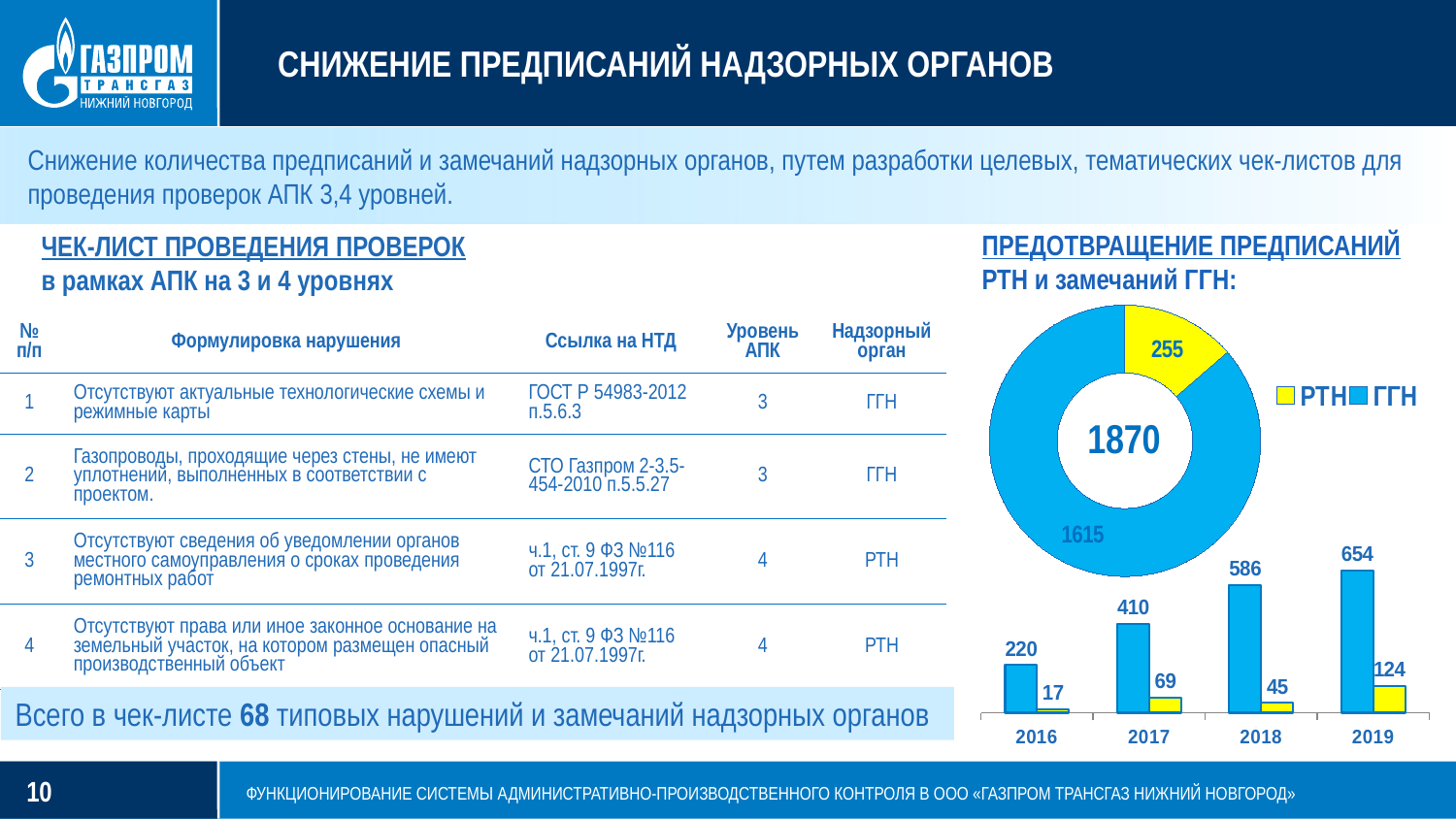
What number is shown in the centre of the doughnut chart? 1870 In the bar chart, which year has the highest blue (ГГН) bar? 2019 In the bar chart, which year has the lowest yellow (РТН) bar? 2016 In the doughnut chart, which category has the larger value, РТН or ГГН? ГГН In the doughnut chart, what is the value for РТН? 255 Do the blue (ГГН) bar values rise or fall from 2016 to 2019? rise In the doughnut chart, what is the difference between the ГГН value and the РТН value? 1360 In the doughnut chart, what is the value for ГГН? 1615 In the bar chart, what is the value of the blue (ГГН) bar for 2019? 654 How many years are shown on the x axis of the bar chart? 4 In the bar chart, what is the difference between the blue (ГГН) values for 2018 and 2017? 176 In the bar chart, what is the value of the yellow (РТН) bar for 2017? 69